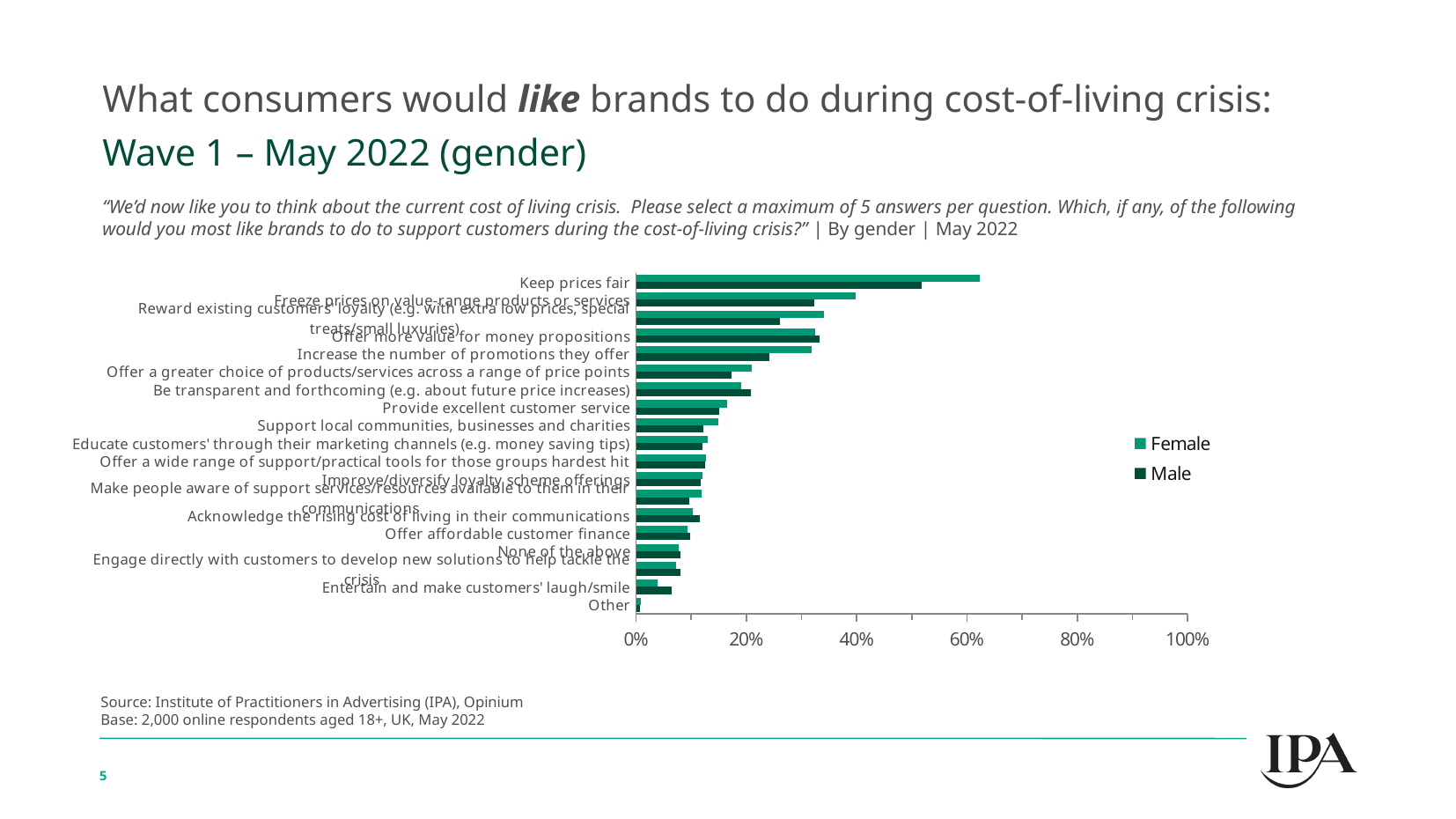
Is the Female value for 'Other' greater or less than 20%? less Is the Male value for 'Freeze prices on value-range products or services' greater or less than 40%? less How many series does the legend list? 2 For 'Keep prices fair', which is larger, the Female value or the Male value? Female Is the Female value for 'Keep prices fair' greater or less than 40%? greater Which category has the highest value for the Female series? Keep prices fair What are the two series named in the legend? Female and Male Which category has the lowest value for the Female series? Other For 'Entertain and make customers' laugh/smile', which is larger, the Female value or the Male value? Male What kind of chart is shown on the slide? bar chart Which category has the highest value for the Male series? Keep prices fair